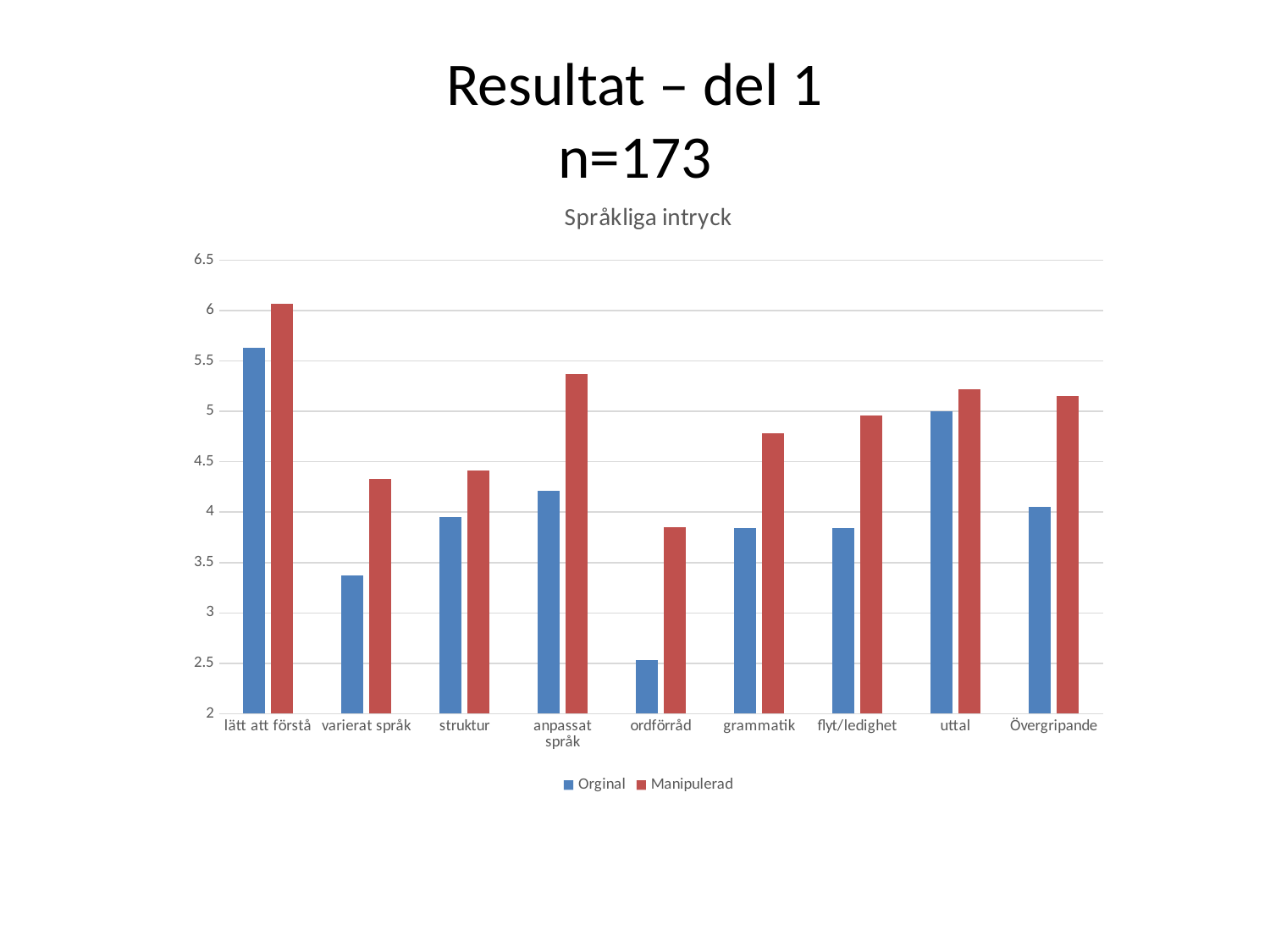
Is the Orginal value for ordförråd greater or less than 3? less Which series is shown in red? Manipulerad What is the title of the chart? Språkliga intryck Is the Orginal value for varierat språk greater or less than 3.5? less Which category has the lowest Orginal value? ordförråd What kind of chart is shown on the slide? bar chart How many categories are shown on the x axis? 9 How many series does the legend list? 2 Which category has the lowest Manipulerad value? ordförråd For grammatik, which series has the larger value, Orginal or Manipulerad? Manipulerad Which category has the highest Manipulerad value? lätt att förstå Is the Manipulerad value for lätt att förstå greater or less than 6? greater